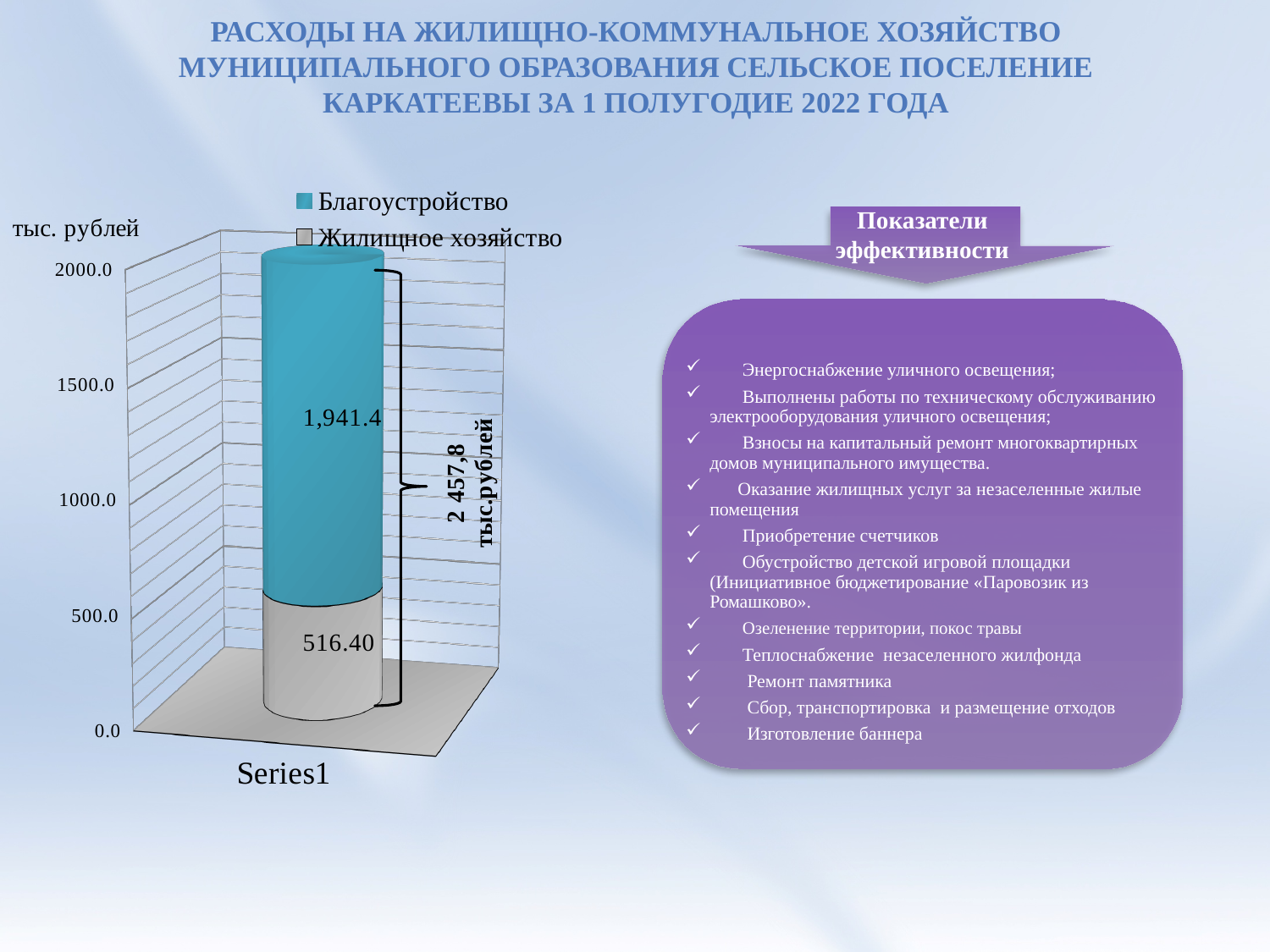
What kind of chart is shown on the slide? Stacked bar chart Which series has the larger value, Благоустройство or Жилищное хозяйство? Благоустройство What unit is shown on the vertical axis of the chart? тыс. рублей How many series does the legend list? 2 What is the total of the stacked bar, as labelled on the slide? 2 457,8 тыс.рублей Which series has the smallest value in the chart? Жилищное хозяйство What is the value for Жилищное хозяйство? 516.40 What is the value for Благоустройство? 1,941.4 What colour represents Благоустройство in the chart? Blue (teal) How many categories are shown on the x axis of the chart? 1 What is the difference between the values for Благоустройство and Жилищное хозяйство? 1,425.0 Is the value for Жилищное хозяйство greater or less than 1000.0? less